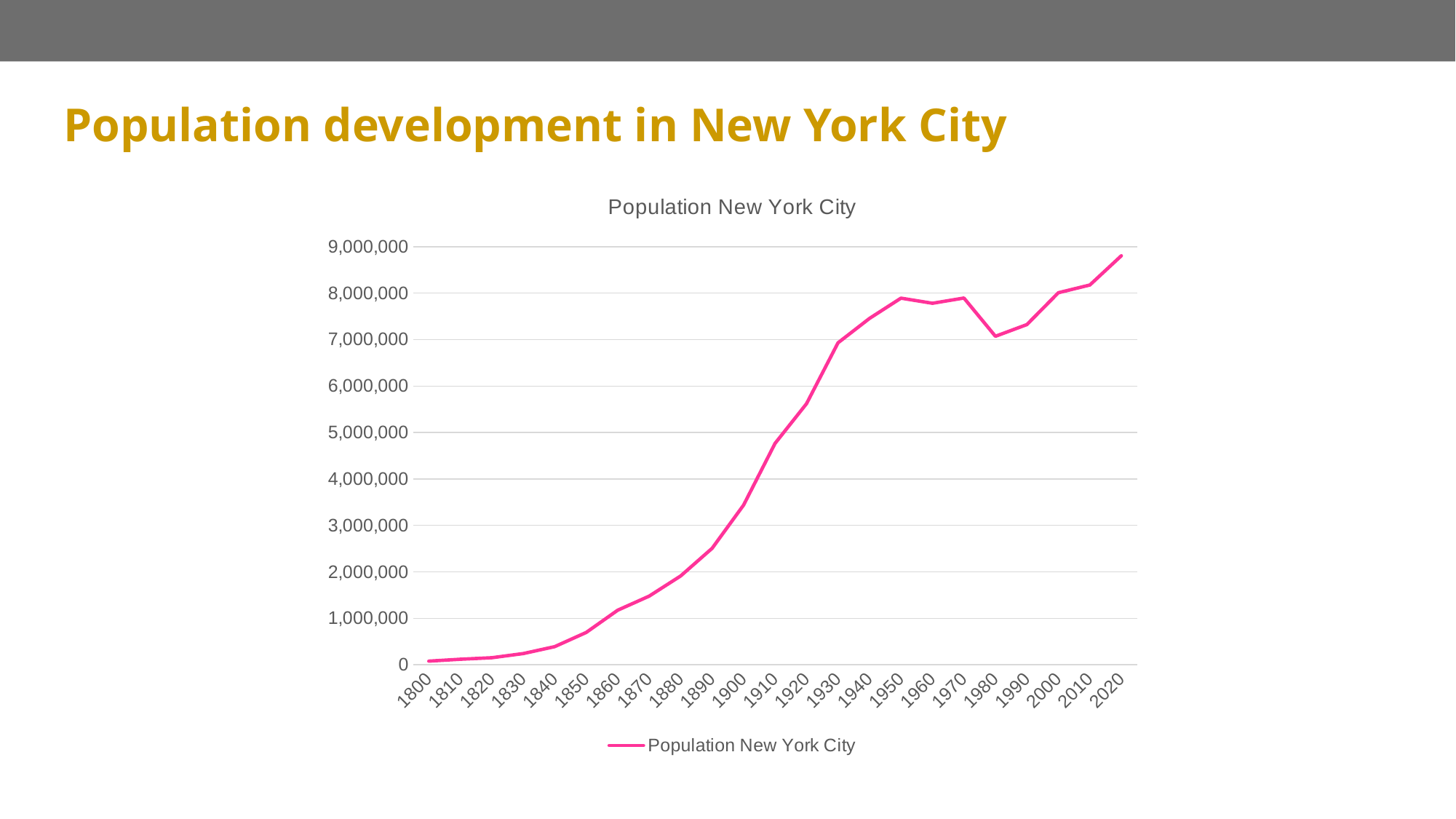
Is the population value for 1920 greater or less than 5,000,000? greater Which year has the lowest population value? 1800 Is the population value for 1850 greater or less than 1,000,000? less Which year has the highest population value? 2020 Does the population generally rise or fall from 1800 to 1950? rise How many series does the legend list? 1 What kind of chart is shown on the slide? line chart Is the population value for 1960 greater or less than 8,000,000? less What is the title of the chart? Population New York City Which year has the larger population value, 1950 or 1980? 1950 How many years are plotted along the x axis? 23